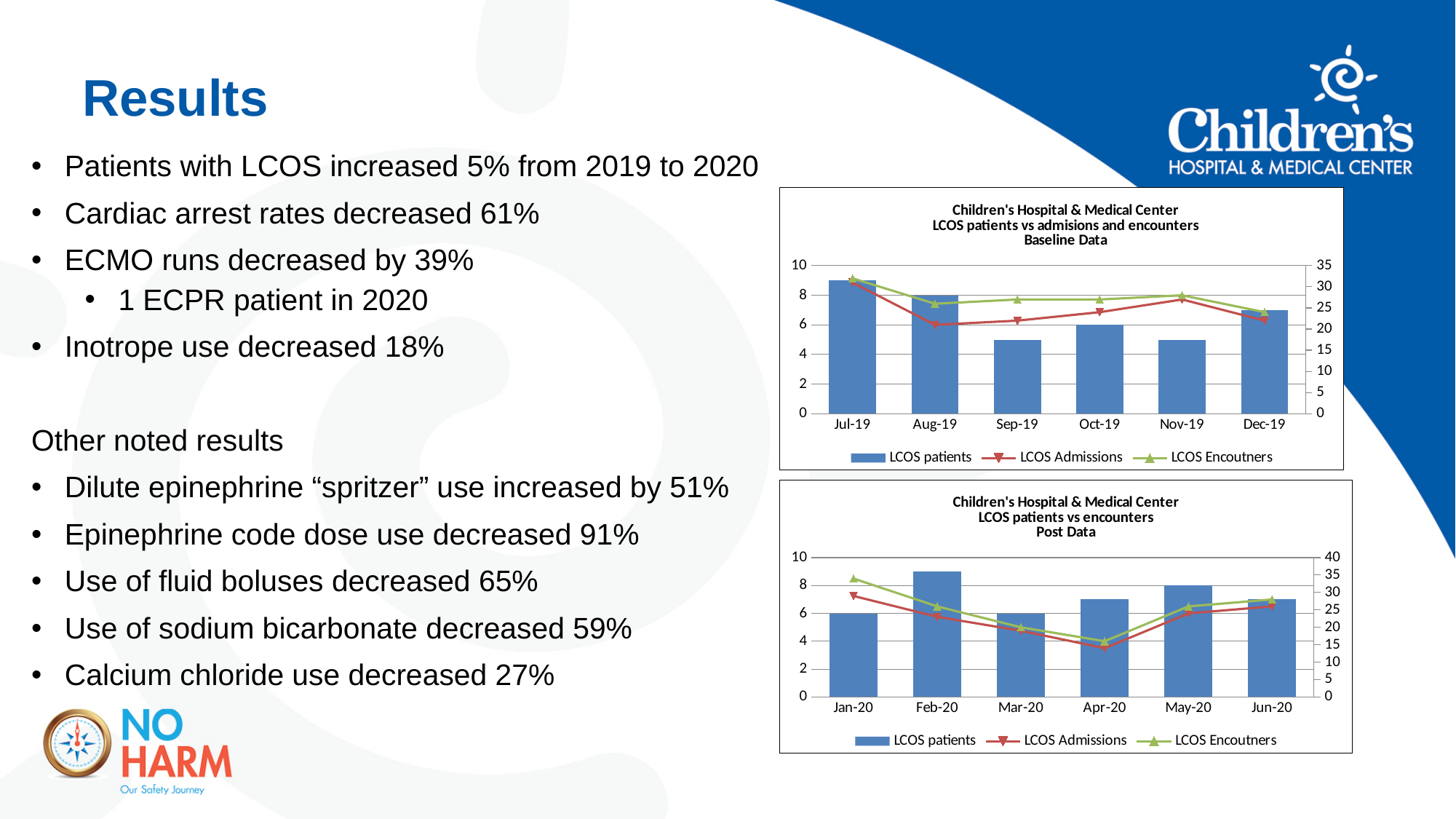
On the Baseline Data chart, what is the difference in LCOS patients between Aug-19 and Oct-19? 2 On the Baseline Data chart, which month has the highest number of LCOS patients? Jul-19 On the Post Data chart, is the LCOS patients value for Apr-20 greater or less than 6? greater On the Post Data chart, does the LCOS Encounters line rise or fall from Jan-20 to Apr-20? fall On the Baseline Data chart, what is the value of LCOS patients for Aug-19? 8 On the Post Data chart, what is the value of LCOS patients for May-20? 8 On the Baseline Data chart, what is the value of LCOS patients for Oct-19? 6 On the Baseline Data chart, is the LCOS patients value for Sep-19 greater or less than 6? less How many series does the legend of the Baseline Data chart list? 3 On the Post Data chart, which month has the highest number of LCOS patients? Feb-20 How many months are shown on the x axis of the Post Data chart? 6 On the Post Data chart, which month has more LCOS patients, Feb-20 or Apr-20? Feb-20